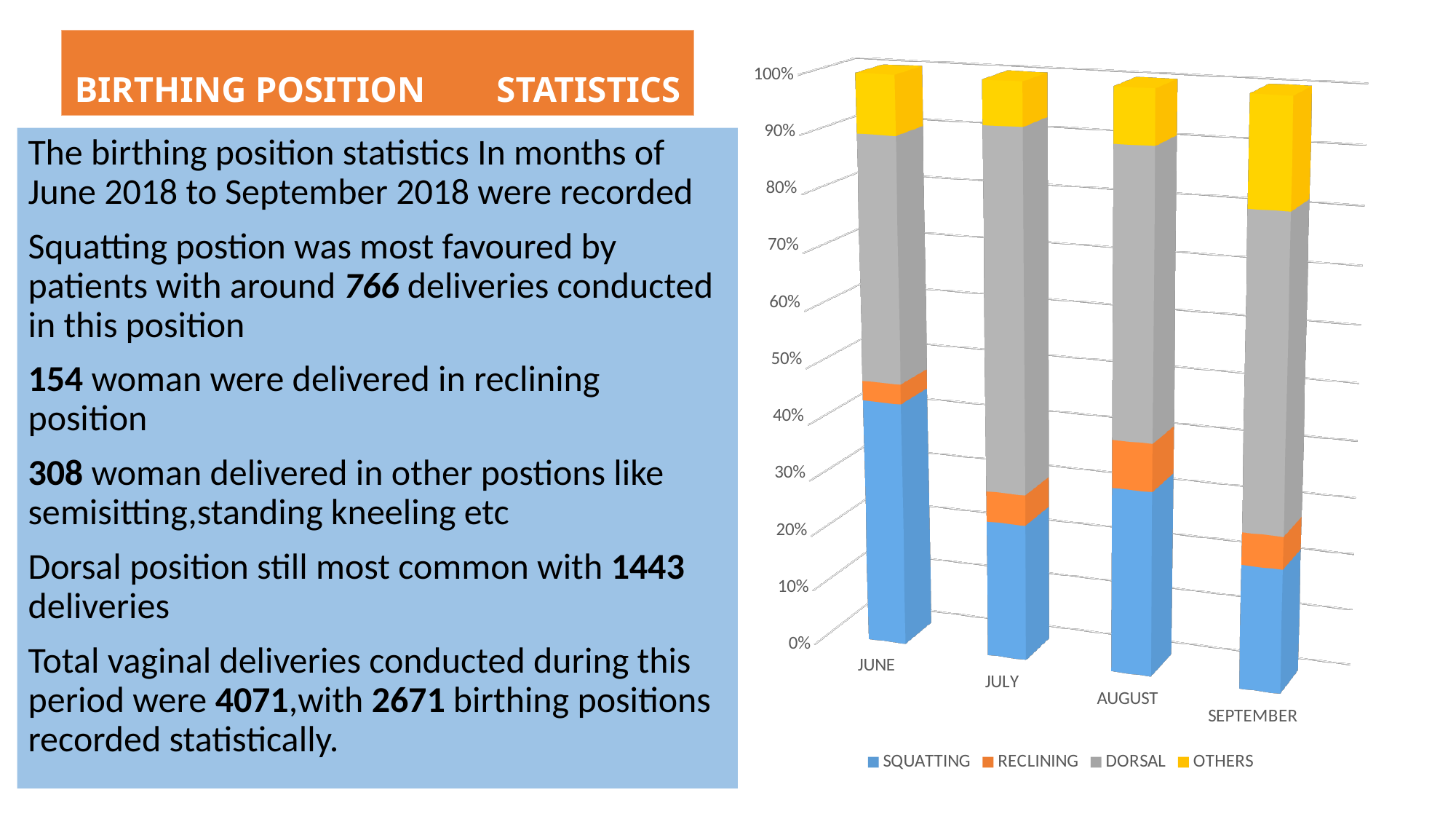
How many series does the chart legend list? 4 Which month has the largest OTHERS share in the chart? SEPTEMBER Which colour represents the SQUATTING series in the chart? Blue What is the highest value shown on the chart's vertical axis? 100% Which is larger, the OTHERS share in SEPTEMBER or in JUNE? SEPTEMBER What kind of chart is shown on the slide? Stacked bar chart How many months are shown on the x axis of the chart? 4 Which month has the smallest SQUATTING share in the chart? SEPTEMBER Is the SQUATTING share for JUNE greater or less than 30%? greater Which month has the largest SQUATTING share in the chart? JUNE Which is larger, the SQUATTING share in JUNE or in JULY? JUNE